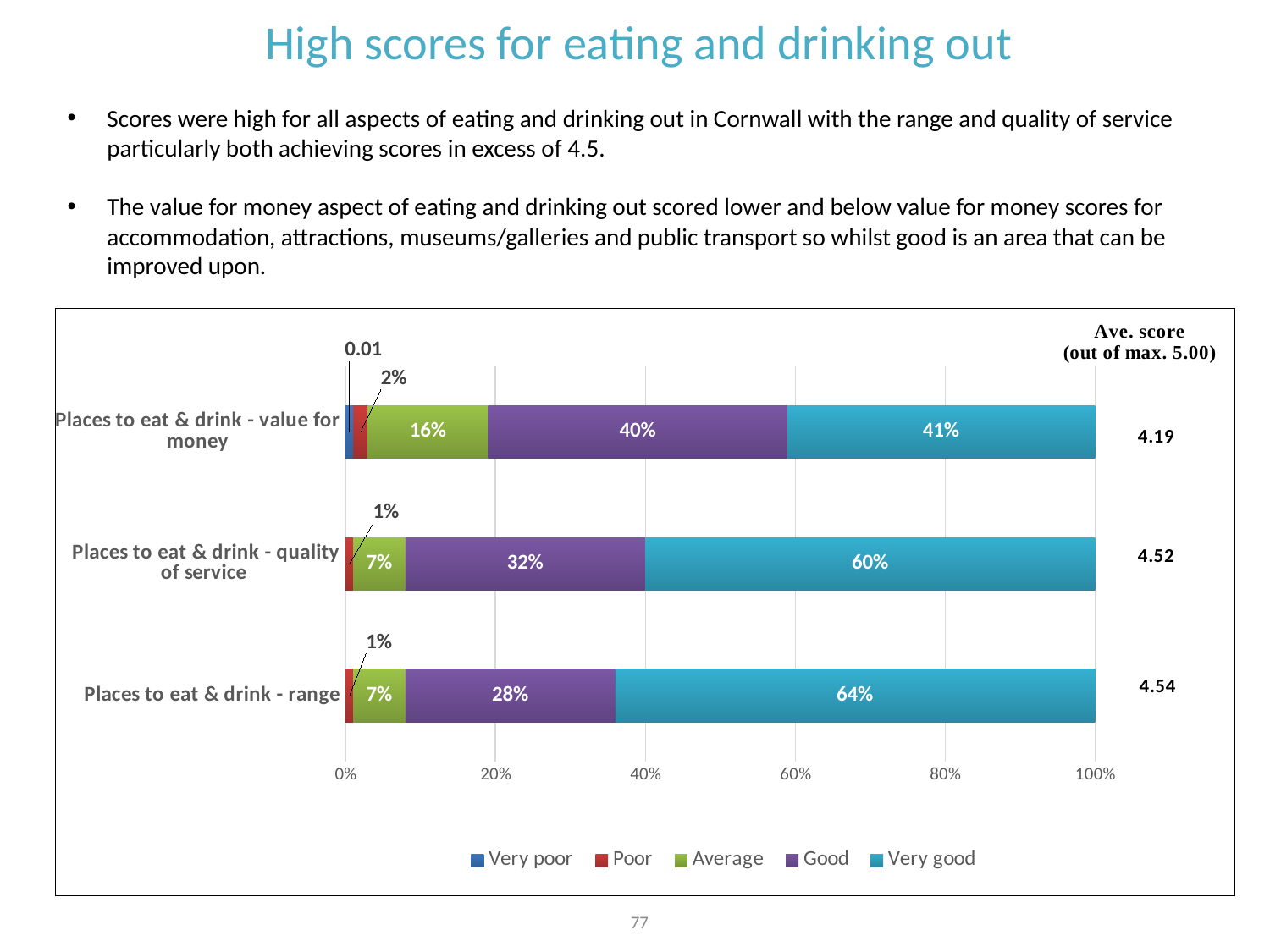
What is the 'Very good' value for 'Places to eat & drink - range'? 64% What is the difference between the 'Very good' values for 'Places to eat & drink - range' and 'Places to eat & drink - value for money'? 23% What is the 'Poor' value for 'Places to eat & drink - value for money'? 2% Which category has the lowest 'Very good' value? Places to eat & drink - value for money Which legend entry is shown in purple? Good How many categories are plotted on the chart? 3 What is the 'Average' value for 'Places to eat & drink - quality of service'? 7% How many series does the legend list? 5 What type of chart is shown on the slide? Stacked bar chart Which category has the highest 'Very good' value? Places to eat & drink - range Is the 'Good' value larger for 'Places to eat & drink - quality of service' or 'Places to eat & drink - range'? Places to eat & drink - quality of service What is the 'Good' value for 'Places to eat & drink - value for money'? 40%